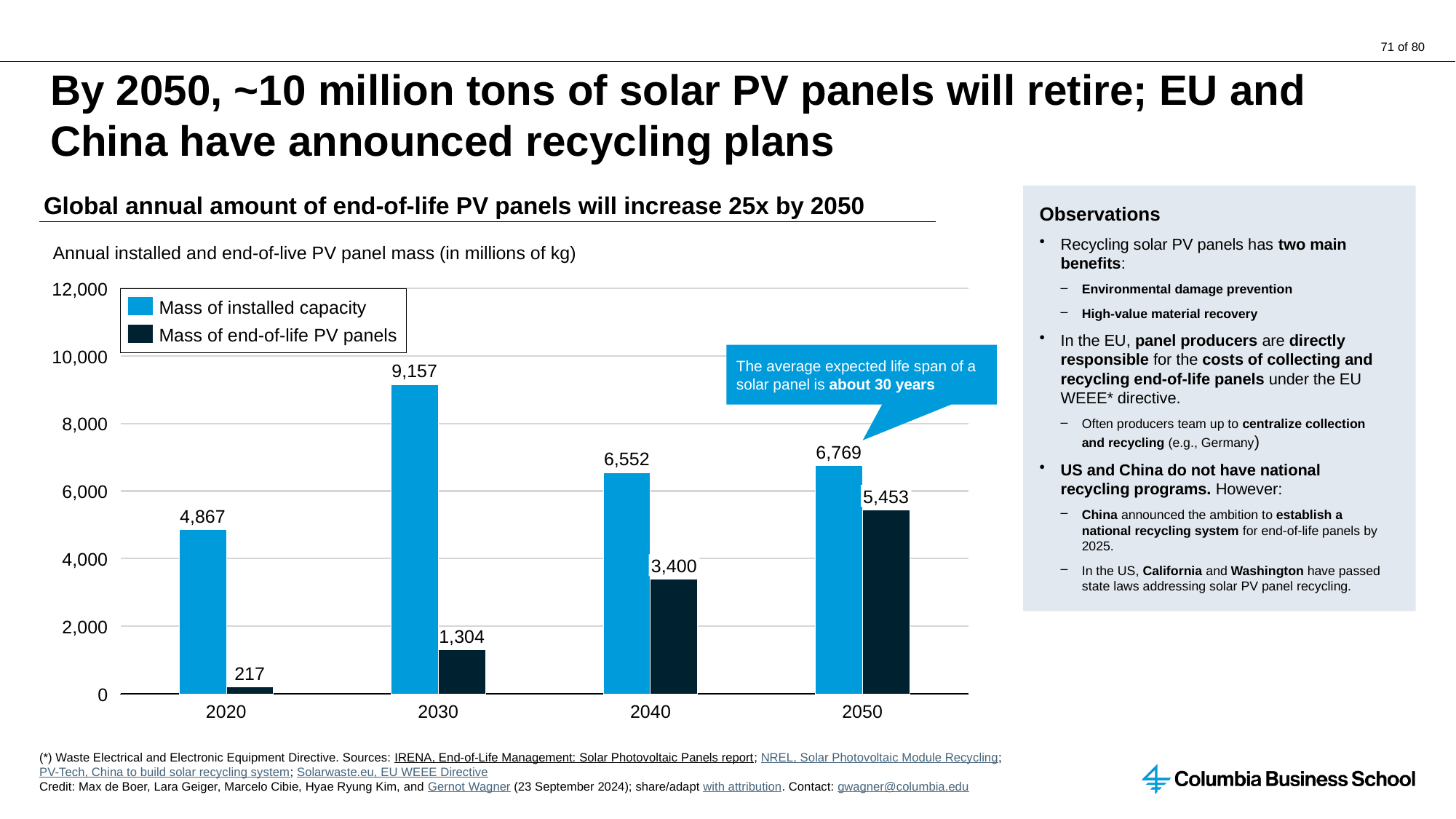
What is the difference between the mass of installed capacity and the mass of end-of-life PV panels in 2040? 3,152 Does the mass of end-of-life PV panels rise or fall from 2020 to 2050? Rise How many years are shown on the x axis? 4 In which year is the mass of end-of-life PV panels lowest? 2020 How many series does the legend list? 2 What is the mass of installed capacity in 2030? 9,157 What is the mass of end-of-life PV panels in 2050? 5,453 What is the mass of end-of-life PV panels in 2020? 217 In which year is the mass of installed capacity highest? 2030 Is the mass of end-of-life PV panels in 2030 greater or less than 2,000? less Which is larger in 2050: the mass of installed capacity or the mass of end-of-life PV panels? Mass of installed capacity What kind of chart is shown on the slide? Bar chart